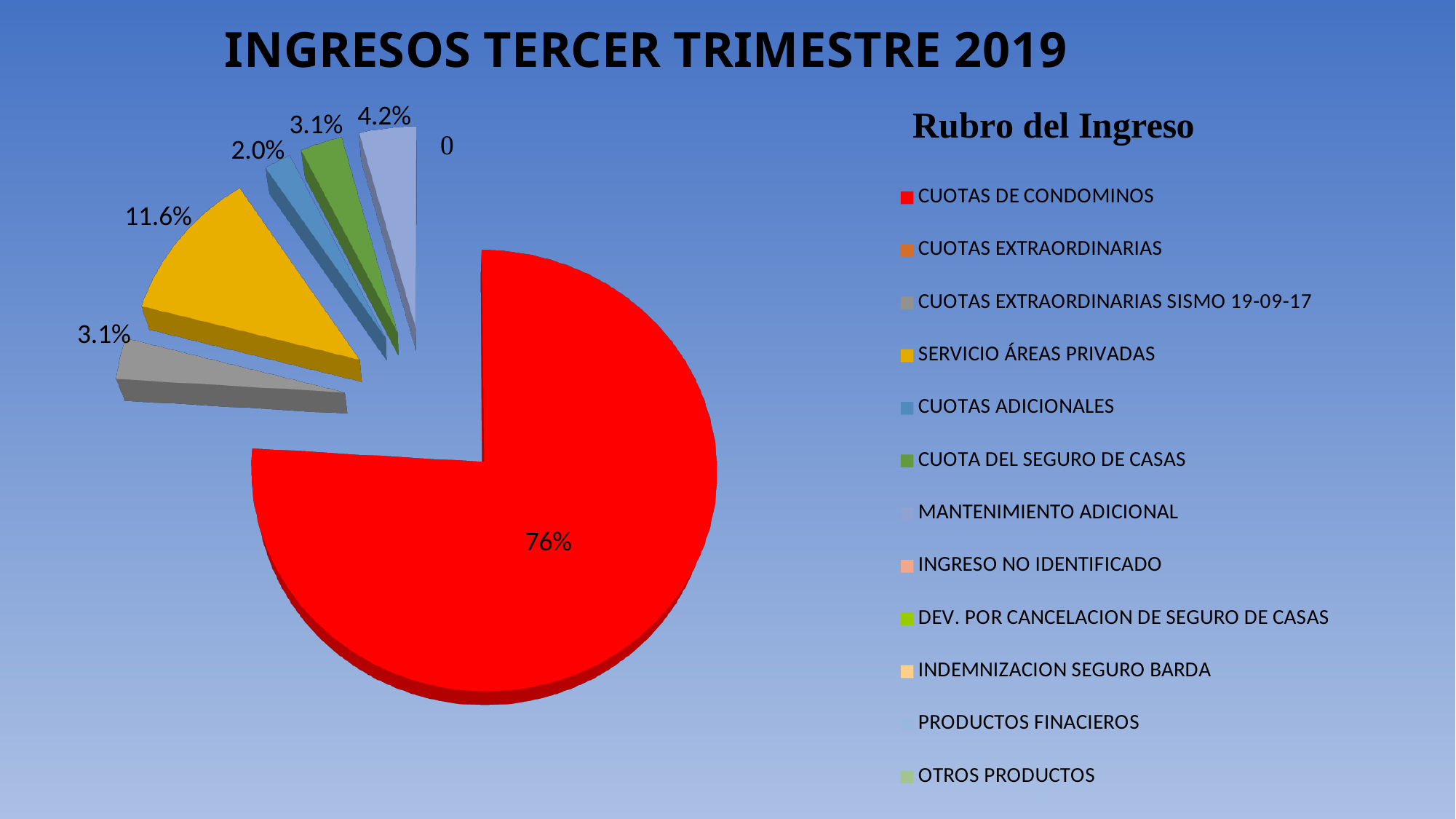
What share of the pie does SERVICIO ÁREAS PRIVADAS represent? 11.6% What is the value shown for MANTENIMIENTO ADICIONAL? 4.2% What is the title of the chart? INGRESOS TERCER TRIMESTRE 2019 What is the value shown for CUOTA DEL SEGURO DE CASAS? 3.1% What is the difference in percentage points between CUOTAS DE CONDOMINOS and SERVICIO ÁREAS PRIVADAS? 64.4% What is the value shown for CUOTAS ADICIONALES? 2.0% Which is larger, the share for SERVICIO ÁREAS PRIVADAS or the share for MANTENIMIENTO ADICIONAL? SERVICIO ÁREAS PRIVADAS What share of the pie does CUOTAS DE CONDOMINOS represent? 76% How many entries does the legend list? 12 Which category has the largest share of the pie? CUOTAS DE CONDOMINOS What kind of chart is shown on the slide? Pie chart What is the heading shown above the legend? Rubro del Ingreso